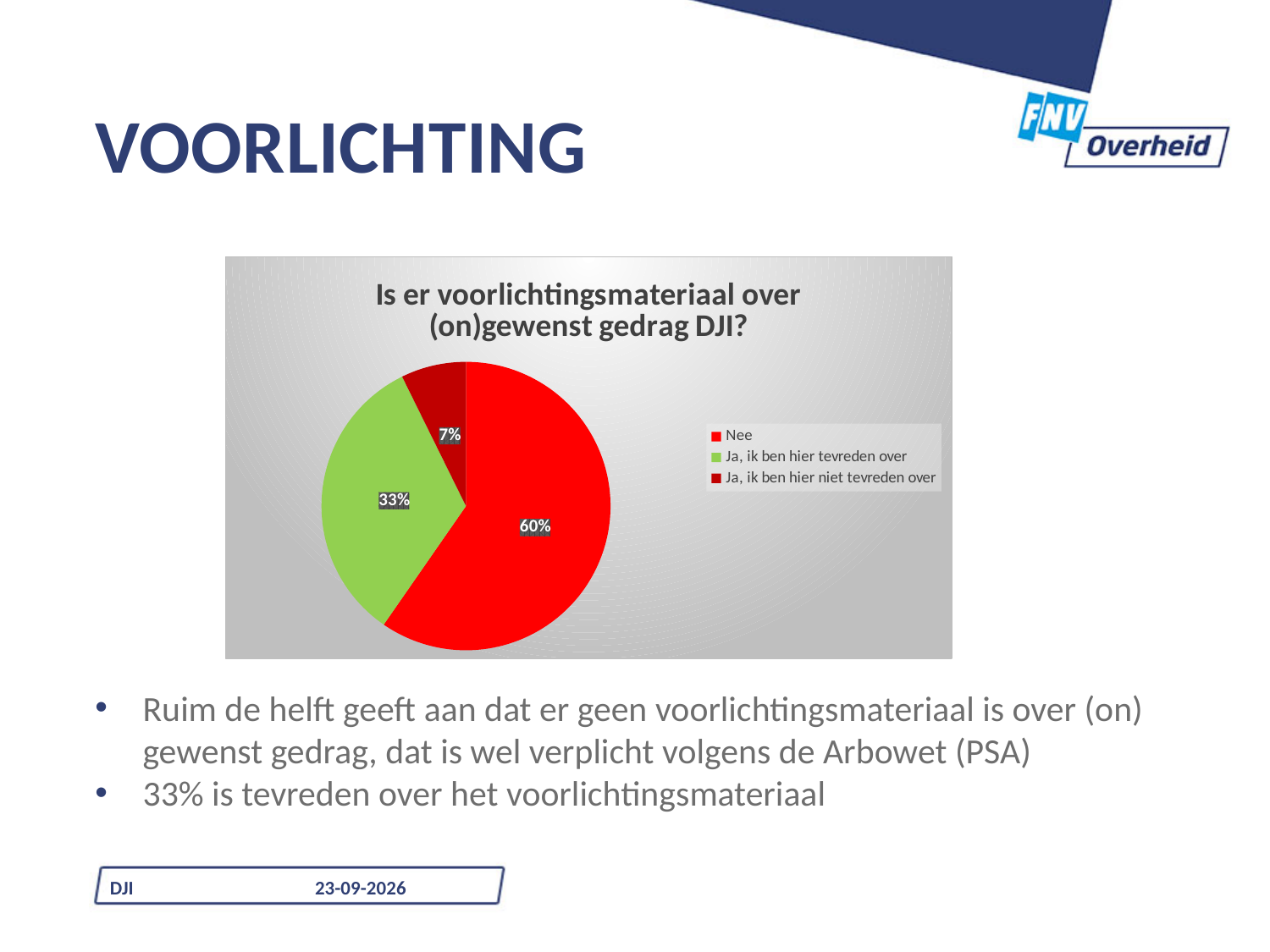
What share of the pie does the "Nee" slice represent? 60% Which is larger: the "Ja, ik ben hier tevreden over" slice or the "Ja, ik ben hier niet tevreden over" slice? Ja, ik ben hier tevreden over What share of the pie does the "Ja, ik ben hier niet tevreden over" slice represent? 7% How many entries does the legend list? 3 What colour is the "Ja, ik ben hier tevreden over" slice? Green Which category has the smallest slice of the pie? Ja, ik ben hier niet tevreden over What share of the pie does the "Ja, ik ben hier tevreden over" slice represent? 33% What is the difference in percentage points between the "Nee" slice and the "Ja, ik ben hier tevreden over" slice? 27 percentage points What is the title of the chart? Is er voorlichtingsmateriaal over (on)gewenst gedrag DJI? What kind of chart is shown on the slide? Pie chart How many slices does the pie chart have? 3 Which category has the largest slice of the pie? Nee